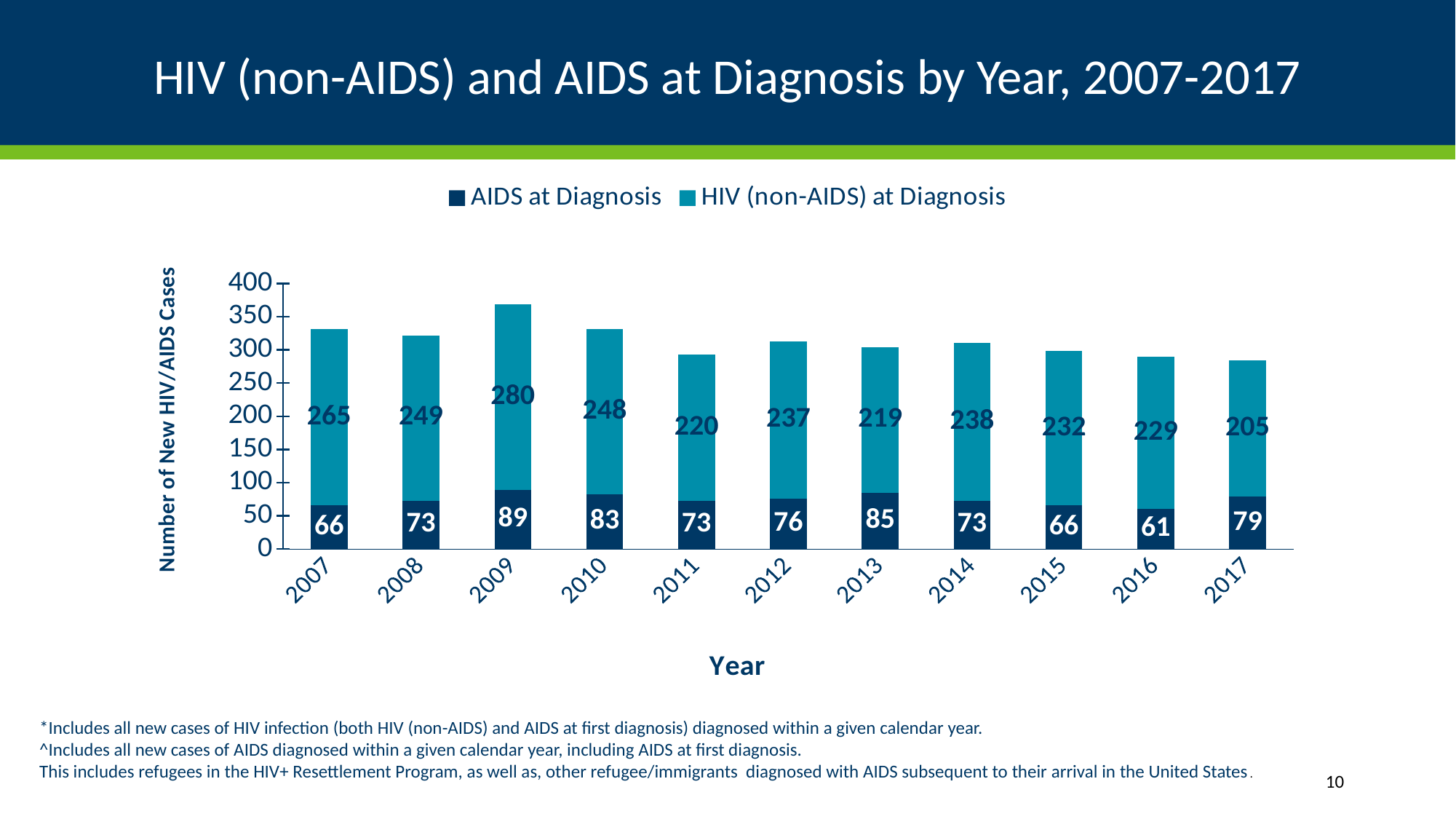
What is the value for HIV (non-AIDS) at Diagnosis in 2009? 280 Do the HIV (non-AIDS) at Diagnosis values rise or fall from 2014 to 2017? Fall Which year has the lowest value for AIDS at Diagnosis? 2016 What is the value for HIV (non-AIDS) at Diagnosis in 2017? 205 What is the value for AIDS at Diagnosis in 2013? 85 What is the total of the stacked bar for 2009? 369 What is the difference between the HIV (non-AIDS) at Diagnosis values for 2009 and 2017? 75 How many series does the legend list? 2 Which year has the highest value for HIV (non-AIDS) at Diagnosis? 2009 What kind of chart is shown on the slide? Stacked bar chart Which is larger, the AIDS at Diagnosis value for 2010 or for 2012? 2010 How many years are shown on the x axis? 11